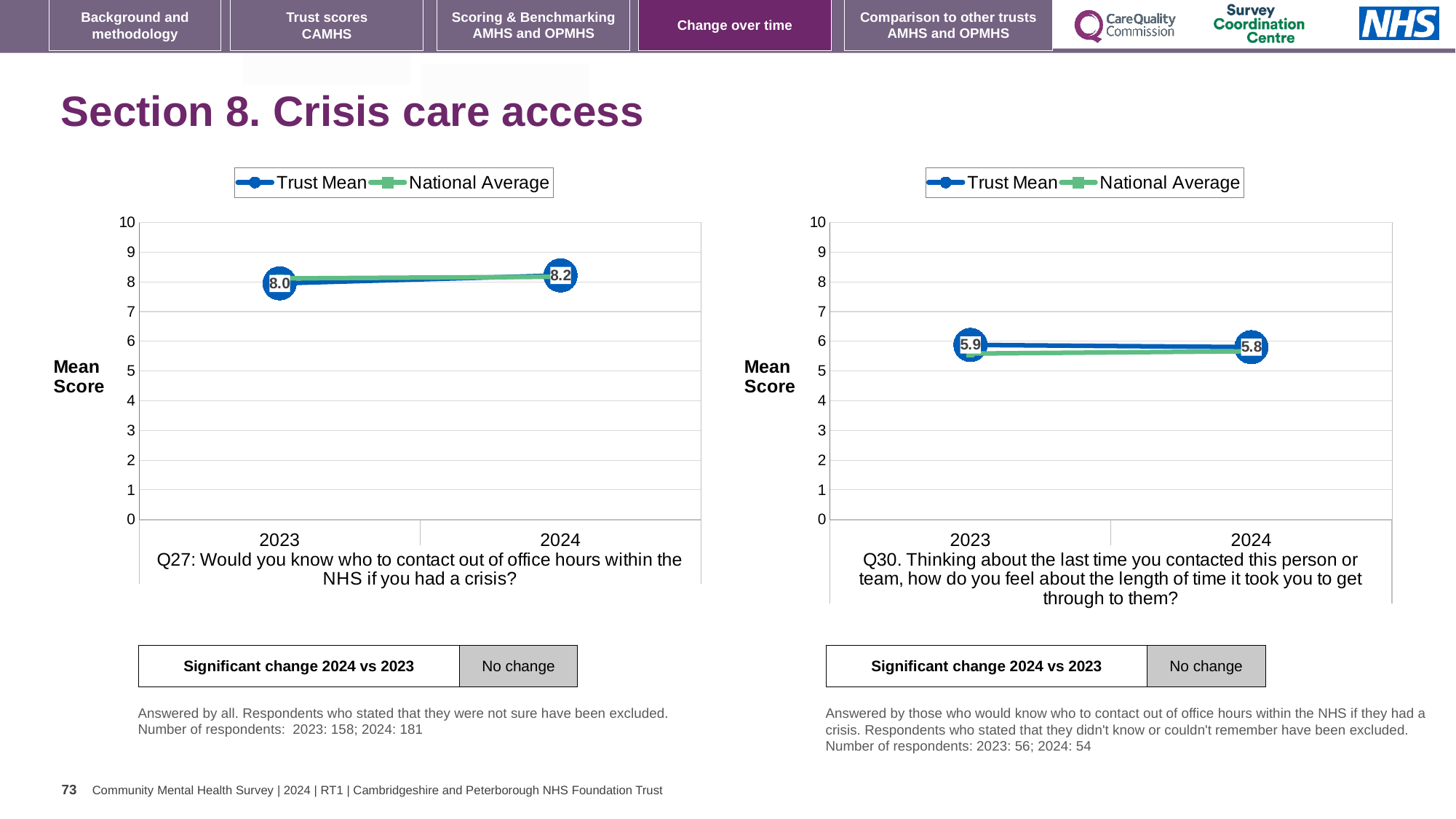
How many years are shown on the x axis of the left chart (Q27)? 2 On the right chart (Q30), is the National Average for 2023 greater or less than 7? less How many series does the legend of the left chart (Q27) list? 2 On the left chart (Q27), what is the Trust Mean score for 2024? 8.2 On the left chart (Q27), does the Trust Mean rise or fall from 2023 to 2024? rise On the right chart (Q30), what is the Trust Mean score for 2024? 5.8 What type of chart is used for Q30 on the right? line chart On the right chart (Q30), what is the Trust Mean score for 2023? 5.9 On the left chart (Q27), by how much did the Trust Mean change from 2023 to 2024? 0.2 On the right chart (Q30), what is the difference between the Trust Mean in 2023 and 2024? 0.1 On the right chart (Q30), does the Trust Mean rise or fall from 2023 to 2024? fall On the left chart (Q27), what is the Trust Mean score for 2023? 8.0